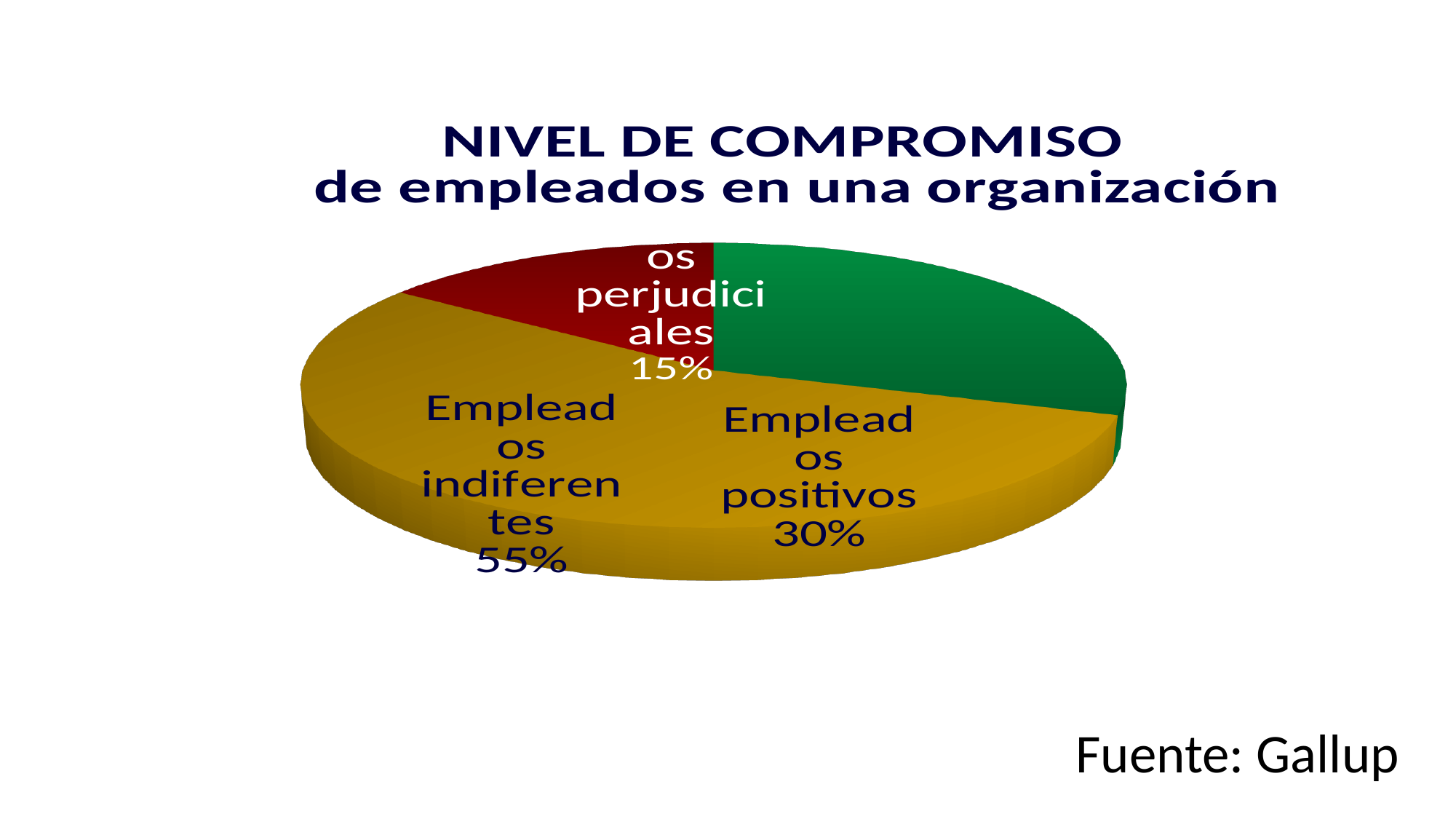
Which category has the smallest share of the pie? Empleados perjudiciales Which category has the largest share of the pie? Empleados indiferentes What percentage of employees are labelled 'Empleados perjudiciales'? 15% What is the difference in percentage points between 'Empleados positivos' and 'Empleados perjudiciales'? 15 What kind of chart is shown on the slide? Pie chart What is the difference in percentage points between 'Empleados indiferentes' and 'Empleados positivos'? 25 What percentage of employees are labelled 'Empleados positivos'? 30% What percentage of employees are labelled 'Empleados indiferentes'? 55% What colour is the slice for 'Empleados perjudiciales'? Red What is the title of the chart? NIVEL DE COMPROMISO de empleados en una organización How many categories does the pie chart show? 3 Which is larger, the share of 'Empleados positivos' or the share of 'Empleados perjudiciales'? Empleados positivos